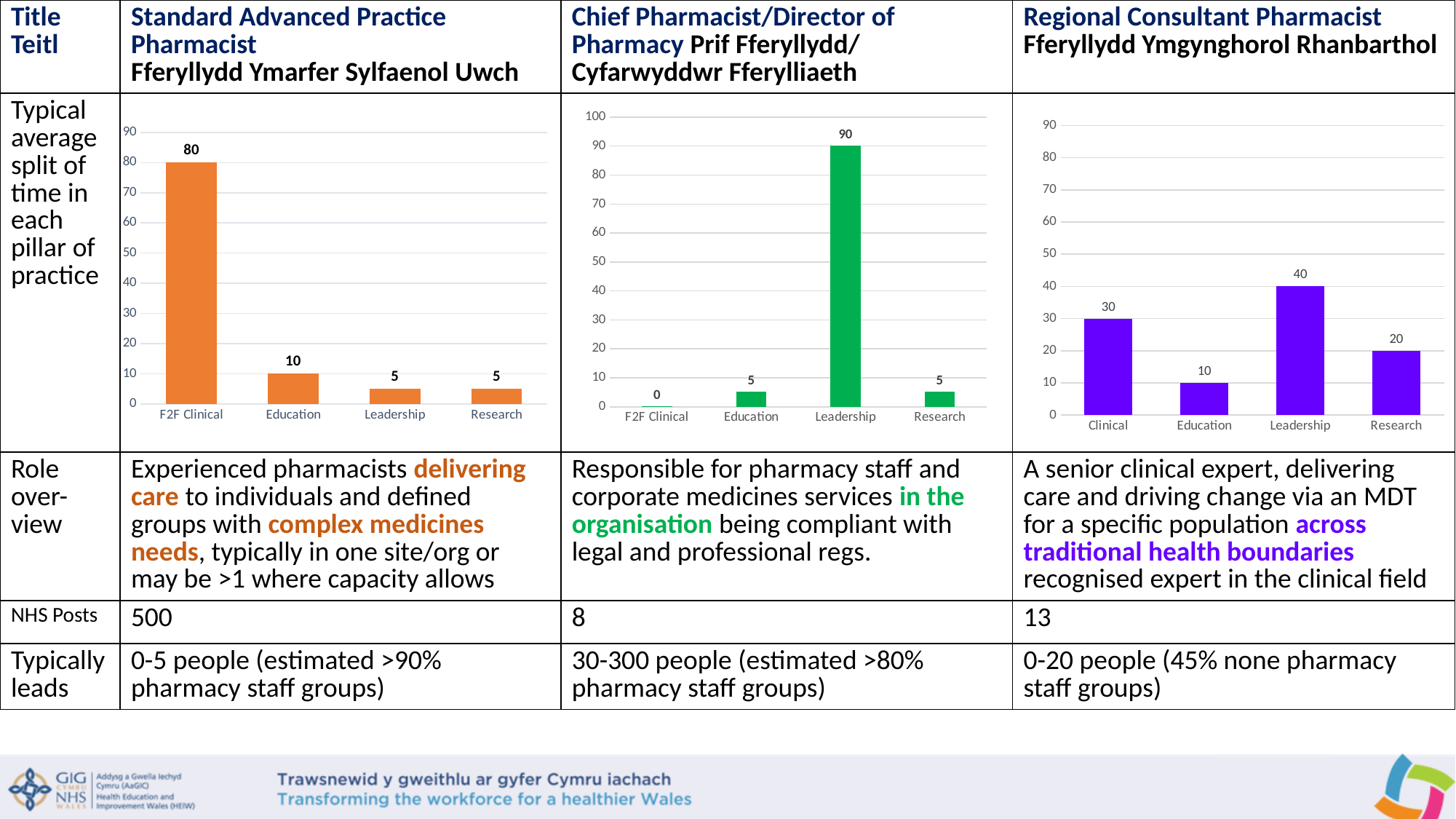
In the Regional Consultant Pharmacist chart (right), what is the difference between Leadership and Clinical? 10 In the Regional Consultant Pharmacist chart (right), which category has the highest value? Leadership How many categories are shown in the Chief Pharmacist/Director of Pharmacy chart (middle)? 4 In the Chief Pharmacist/Director of Pharmacy chart (middle), what is the value for Leadership? 90 In the Chief Pharmacist/Director of Pharmacy chart (middle), which category has the lowest value? F2F Clinical In the Standard Advanced Practice Pharmacist chart (left), what is the total of all four categories? 100 What type of chart is used in the Standard Advanced Practice Pharmacist column (left)? Bar chart In the Regional Consultant Pharmacist chart (right), what is the value for Research? 20 In the Standard Advanced Practice Pharmacist chart (left), what is the difference between F2F Clinical and Education? 70 In the Regional Consultant Pharmacist chart (right), which is larger, Clinical or Research? Clinical In the Standard Advanced Practice Pharmacist chart (left), what is the value for F2F Clinical? 80 What colour are the bars in the Regional Consultant Pharmacist chart (right)? Purple